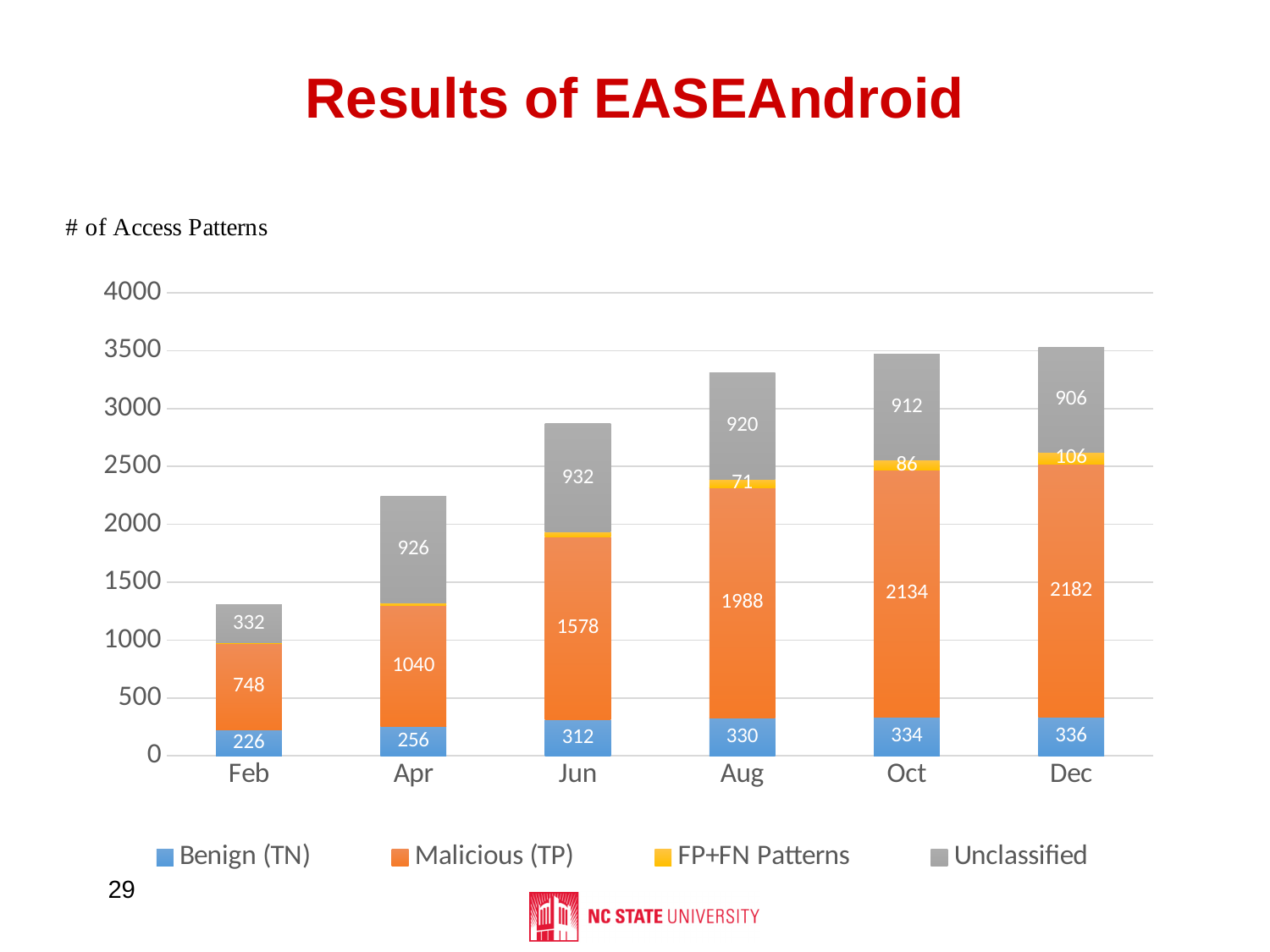
What is the total of the Dec stacked bar? 3530 Which month has the lowest Unclassified value? Feb Is the total height of the Jun stacked bar greater or less than 2500? greater Which month has the highest Malicious (TP) value? Dec Which is larger, the Benign (TN) value for Apr or for Jun? Jun What is the Malicious (TP) value for Jun? 1578 What is the FP+FN Patterns value for Dec? 106 What kind of chart is shown on the slide? Stacked bar chart What is the difference between the Malicious (TP) values for Oct and Aug? 146 How many series does the legend list? 4 What is the Unclassified value for Apr? 926 How many months are shown on the x axis? 6